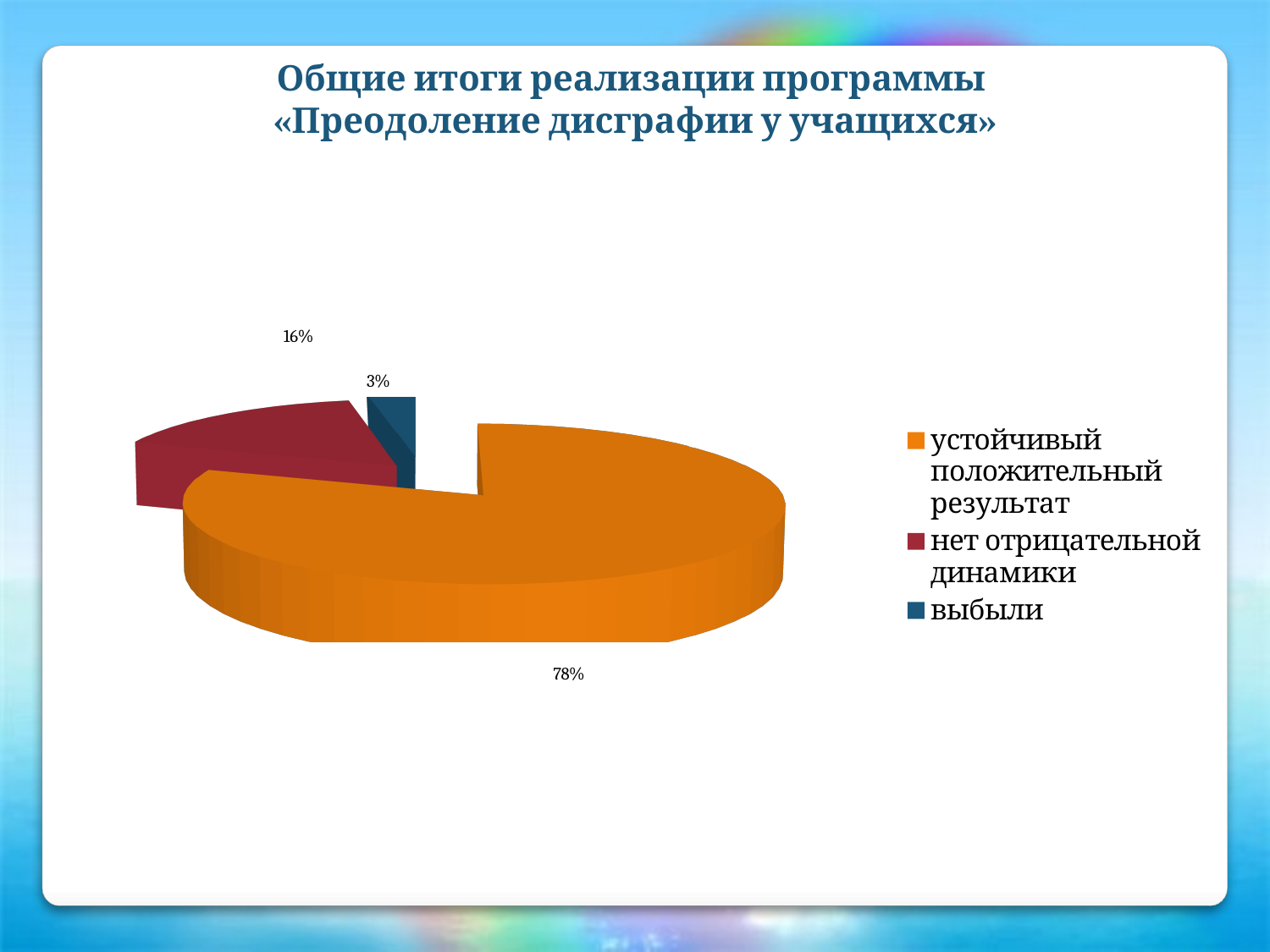
Which category has the smallest slice of the pie? выбыли Which is larger: the share for «нет отрицательной динамики» or the share for «выбыли»? нет отрицательной динамики What share of the pie does «устойчивый положительный результат» have? 78% What kind of chart is shown on the slide? Pie chart What is the difference in percentage points between «устойчивый положительный результат» and «нет отрицательной динамики»? 62 What share of the pie does «выбыли» have? 3% How many entries does the legend list? 3 Which category has the largest slice of the pie? устойчивый положительный результат What is the title of the slide containing the chart? Общие итоги реализации программы «Преодоление дисграфии у учащихся» How many slices does the pie chart have? 3 What colour is the slice for «выбыли»? Blue What share of the pie does «нет отрицательной динамики» have? 16%